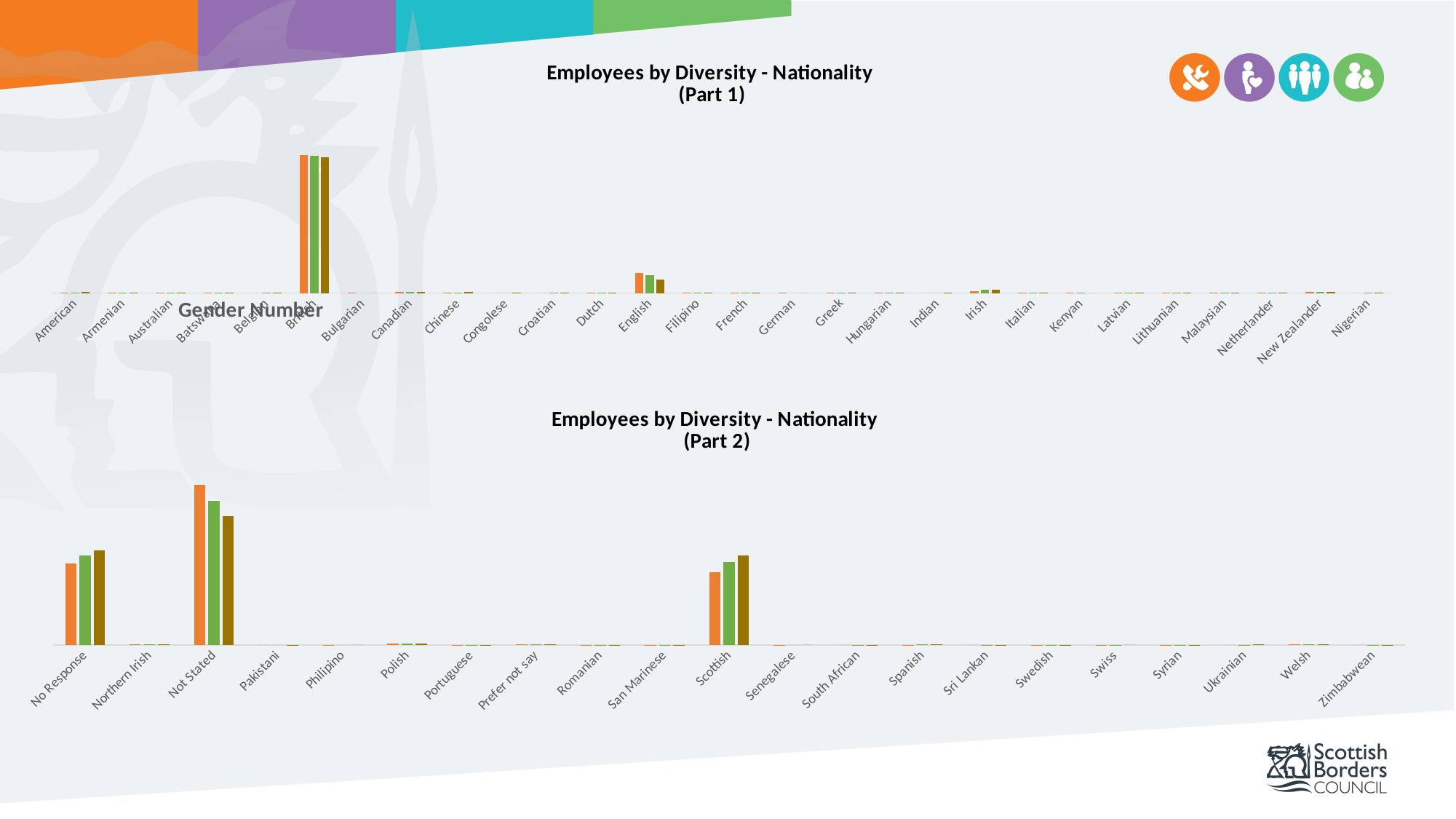
How many bars (series) are plotted for each category in the 'Employees by Diversity - Nationality (Part 2)' chart? 3 What kind of chart is the 'Employees by Diversity - Nationality (Part 1)' chart? bar chart In the 'Employees by Diversity - Nationality (Part 2)' chart, which is larger, the value for Not Stated or the value for Scottish? Not Stated In the 'Employees by Diversity - Nationality (Part 2)' chart, which is larger, the value for Scottish or the value for No Response? No Response What kind of chart is the 'Employees by Diversity - Nationality (Part 2)' chart? bar chart How many categories are shown on the x axis of the 'Employees by Diversity - Nationality (Part 2)' chart? 21 How many nationality categories are shown on the x axis of the 'Employees by Diversity - Nationality (Part 1)' chart? 28 In the 'Employees by Diversity - Nationality (Part 1)' chart, which is larger, the value for English or the value for Irish? English In the 'Employees by Diversity - Nationality (Part 2)' chart, which category has the highest bars? Not Stated In the 'Employees by Diversity - Nationality (Part 1)' chart, which nationality has the highest bars? British What is the title of the top chart on the slide? Employees by Diversity - Nationality (Part 1)